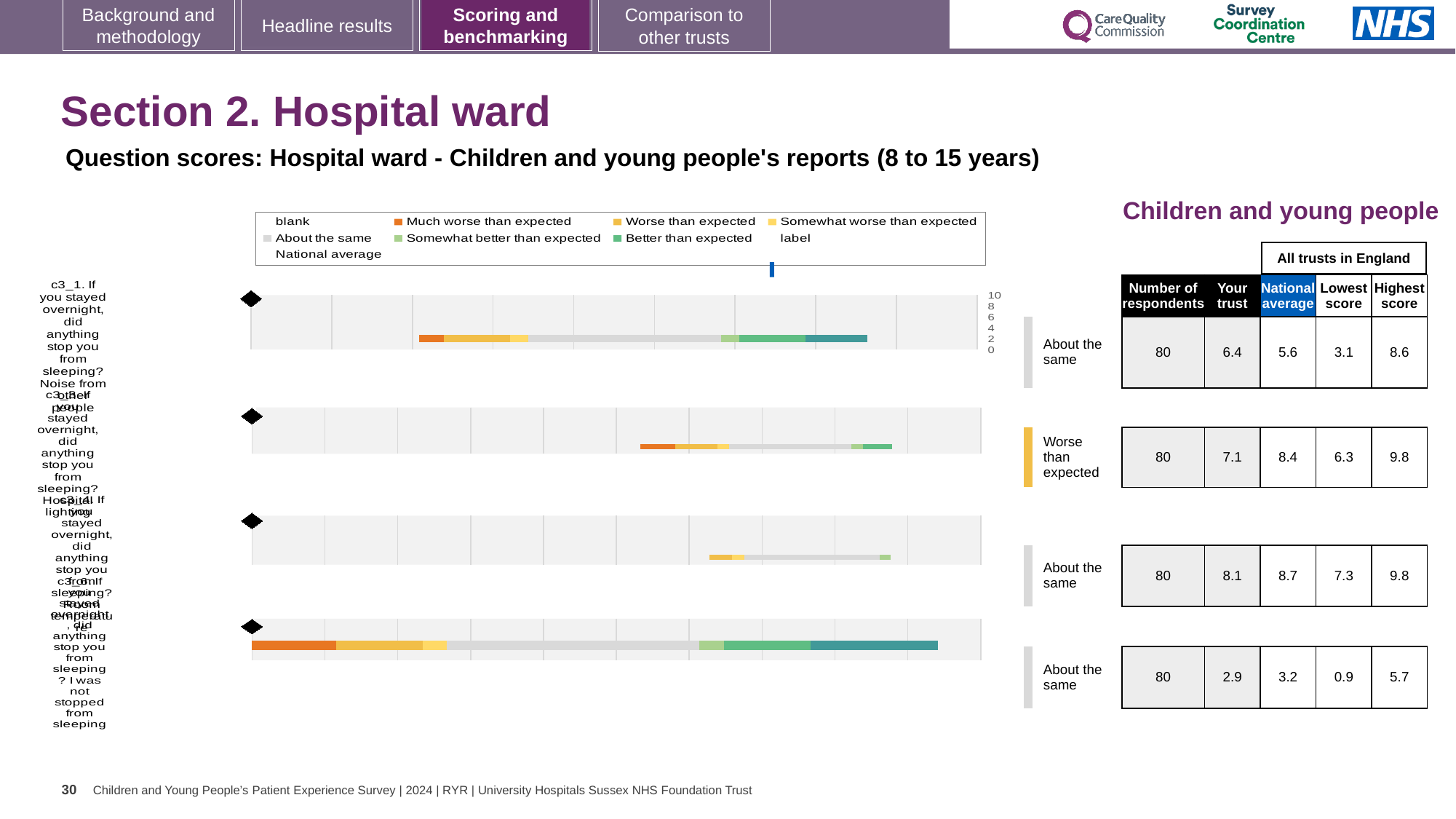
How many question-score bar charts are shown on the slide? 4 For the first chart row (c3_1, noise from other people), what is the national average score? 5.6 For the second chart row (c3_3, hospital lighting), what is the 'Your trust' score? 7.1 Which chart row is rated 'Worse than expected'? the second row (c3_3, hospital lighting) Which chart row has the highest 'Your trust' score? the third row (c3_4), 8.1 For the fourth chart row (c3_6, I was not stopped from sleeping), what is the lowest score among all trusts in England? 0.9 In the chart legend, what colour represents 'Much worse than expected'? orange For the first chart row (c3_1, noise from other people), what is the 'Your trust' score? 6.4 What is the maximum value shown on the x axis of the bar charts? 10 For the second chart row (c3_3, hospital lighting), what is the difference between the national average (8.4) and the 'Your trust' score (7.1)? 1.3 How many respondents are listed for each of the four chart rows? 80 What kind of chart is used for the question scores on this slide? bar chart